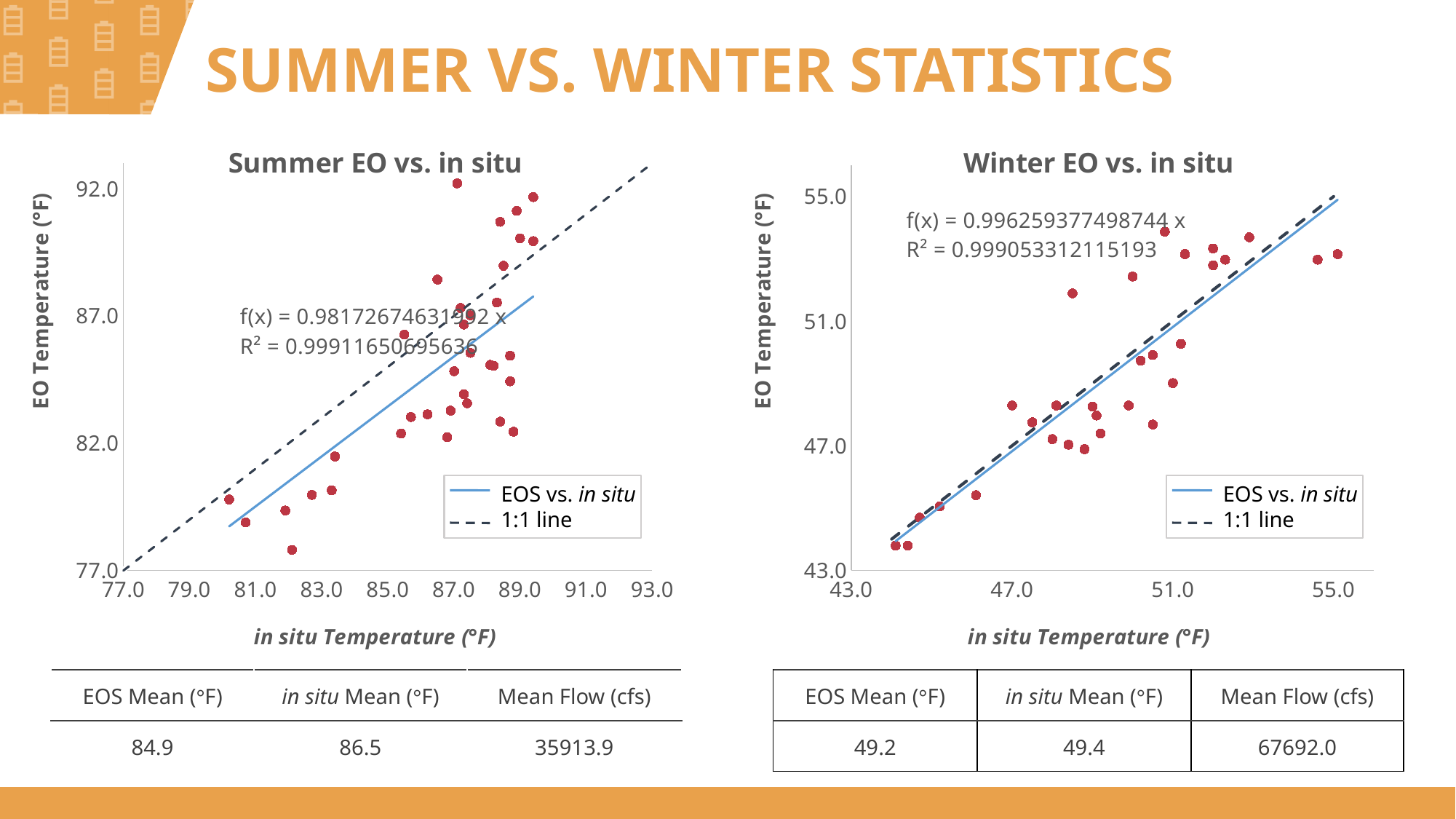
In the "Summer EO vs. in situ" chart, how many entries does the legend list? 2 In the "Summer EO vs. in situ" chart, do the EO temperature values generally rise or fall as in situ temperature increases? Rise In the "Summer EO vs. in situ" chart, what is the R² value printed on the chart? 0.99911650695636 In the "Summer EO vs. in situ" chart, what is the fitted equation f(x) shown on the chart? f(x) = 0.98172674631992 x In the "Winter EO vs. in situ" chart, what is the R² value printed on the chart? 0.999053312115193 In the "Winter EO vs. in situ" chart, what is the fitted equation f(x) shown on the chart? f(x) = 0.996259377498744 x What kind of chart is the "Winter EO vs. in situ" chart? Scatter chart In the "Summer EO vs. in situ" chart, is the EO temperature of the lowest plotted point greater or less than 82.0? less What kind of chart is the "Summer EO vs. in situ" chart? Scatter chart Which chart has the higher slope coefficient in its fitted equation, "Summer EO vs. in situ" or "Winter EO vs. in situ"? Winter EO vs. in situ In the "Winter EO vs. in situ" chart, what is the label of the y axis? EO Temperature (°F) In the "Winter EO vs. in situ" chart, what are the two legend entries? EOS vs. in situ; 1:1 line